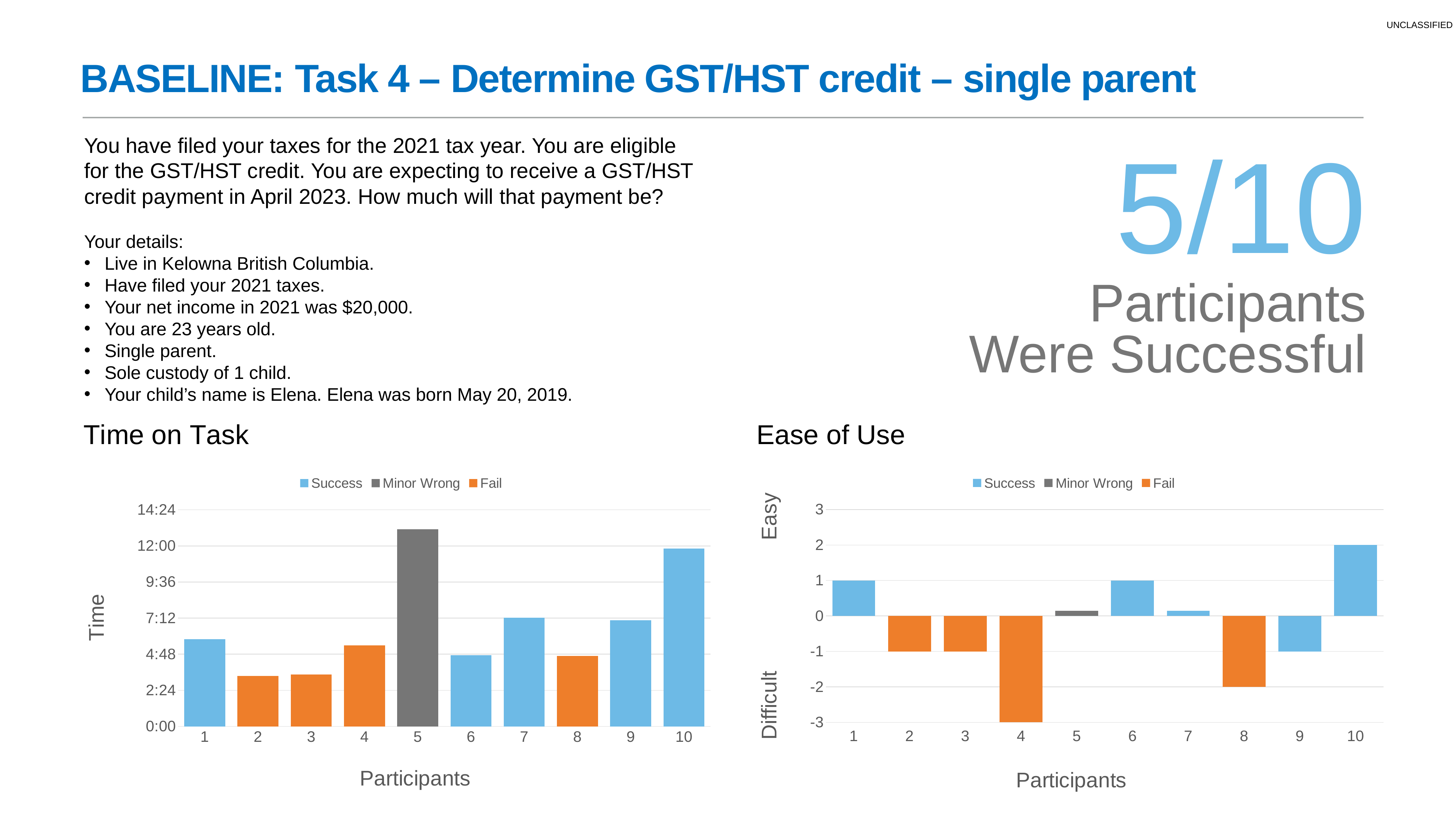
In the Ease of Use chart, what is the value for participant 10? 2 In the Time on Task chart, which participant took longer, participant 1 or participant 2? participant 1 How many series does the legend of the Time on Task chart list? 3 What kind of chart is the Time on Task chart? bar chart In the Ease of Use chart, what is the value for participant 4? -3 In the Ease of Use chart, what is the difference between the values for participant 10 and participant 4? 5 How many participants are shown on the x axis of the Time on Task chart? 10 In the Ease of Use chart, which participant has the lowest value? 4 In the Time on Task chart, is the time for participant 10 greater or less than 9:36? greater In the Ease of Use chart, what are the two labels on the vertical axis? Easy and Difficult In the Time on Task chart, which participant has the highest time? 5 In the Time on Task chart, is the time for participant 5 greater or less than 12:00? greater